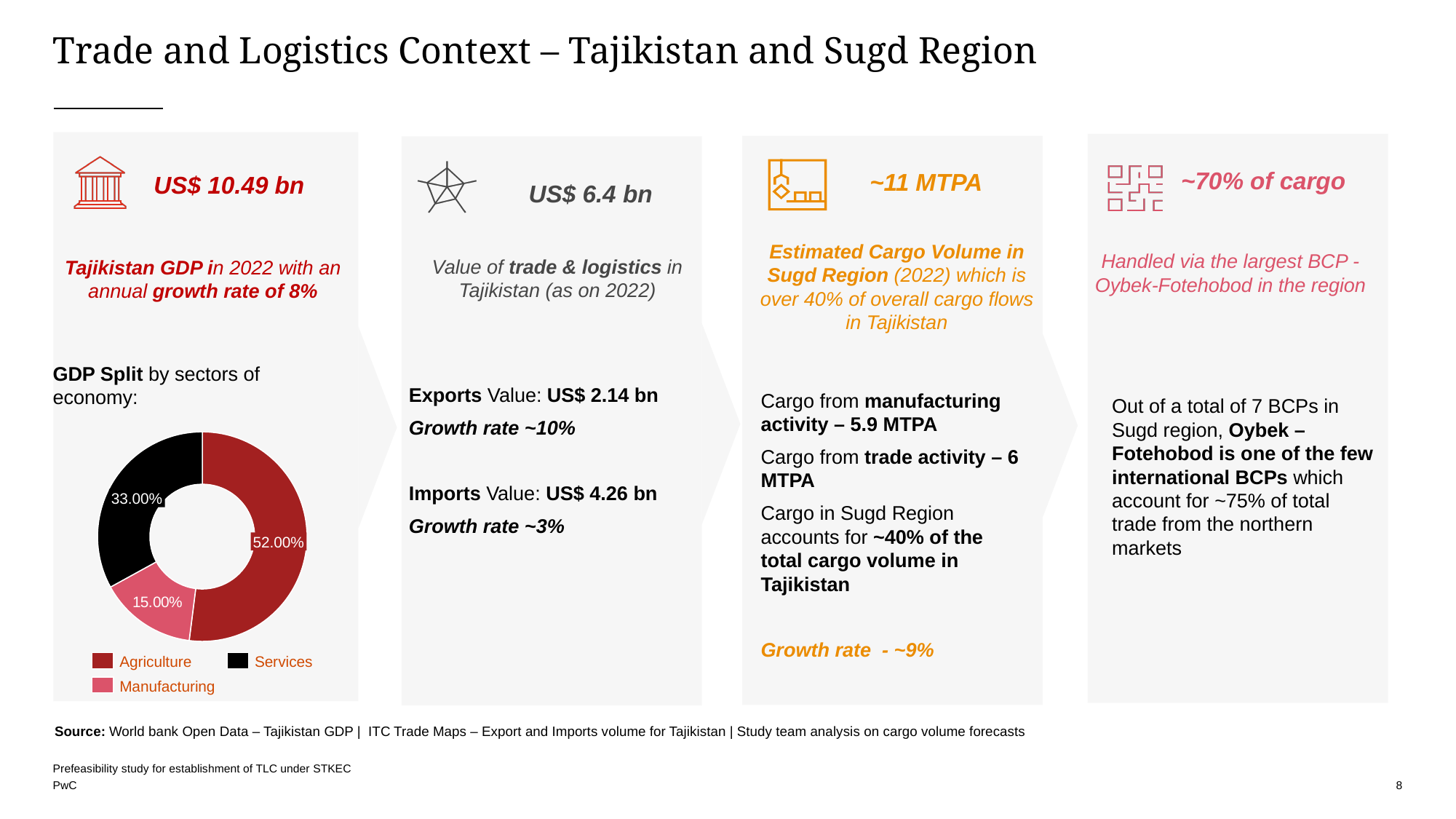
Which sector has the smallest share in the GDP split chart? Manufacturing Which sector has the largest share in the GDP split chart? Agriculture How many sectors are shown in the GDP split chart? 3 What share of GDP does Services account for in the GDP split chart? 33.00% In the GDP split chart, which is larger: the Services share or the Manufacturing share? Services In the GDP split chart, what is the difference in percentage points between the Agriculture and Services shares? 19.00% What colour represents Agriculture in the GDP split chart? Dark red What share of GDP does Agriculture account for in the GDP split chart? 52.00% What colour represents Services in the GDP split chart? Black In the GDP split chart, what is the difference in percentage points between the Services and Manufacturing shares? 18.00% What kind of chart is used to show the GDP split by sectors of economy? Pie chart (donut) What share of GDP does Manufacturing account for in the GDP split chart? 15.00%